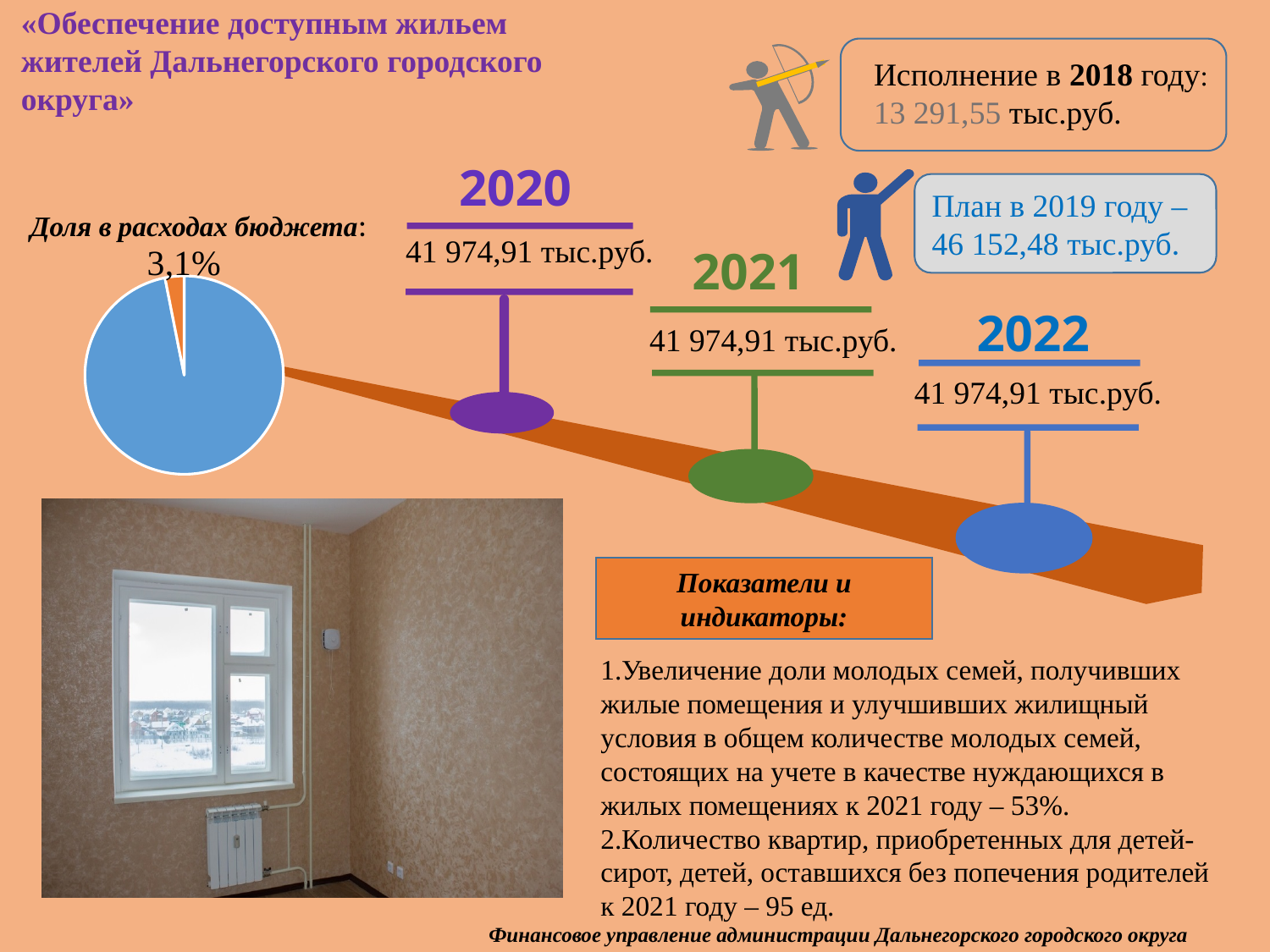
What is the title printed above the pie chart? Доля в расходах бюджета What kind of chart is shown under the heading «Доля в расходах бюджета»? pie chart Which slice of the pie chart «Доля в расходах бюджета» is the smallest? the orange slice (3,1%) In the pie chart «Доля в расходах бюджета», which slice is larger, the blue one or the orange one? the blue one What share of the pie chart «Доля в расходах бюджета» does the labelled orange slice represent? 3,1% In the pie chart «Доля в расходах бюджета», what value is printed for the small orange slice? 3,1% What colour is the slice of the pie chart that is labelled 3,1%? orange How many slices does the pie chart «Доля в расходах бюджета» have? 2